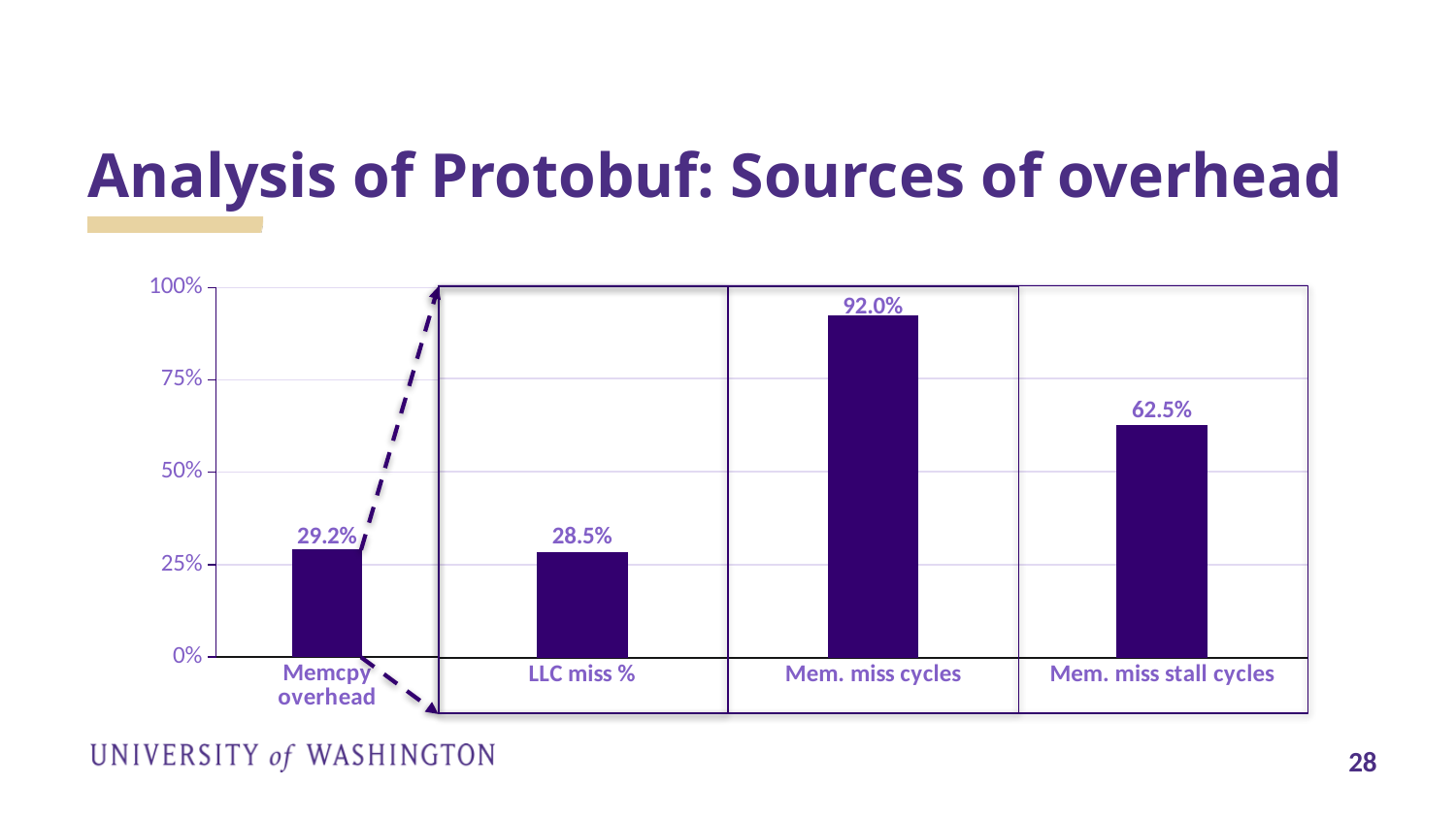
What kind of chart is shown on the slide? Bar chart What is the value for LLC miss %? 28.5% How many categories are shown on the x axis? 4 What is the difference between Memcpy overhead and LLC miss %? 0.7% Is the value for Mem. miss stall cycles greater or less than 50%? greater What is the title of the slide containing the chart? Analysis of Protobuf: Sources of overhead Which category has the highest value? Mem. miss cycles What is the value for Mem. miss cycles? 92.0% Which is larger, Mem. miss stall cycles or Memcpy overhead? Mem. miss stall cycles What is the value for Memcpy overhead? 29.2% What is the difference between Mem. miss cycles and Mem. miss stall cycles? 29.5% What is the value for Mem. miss stall cycles? 62.5%